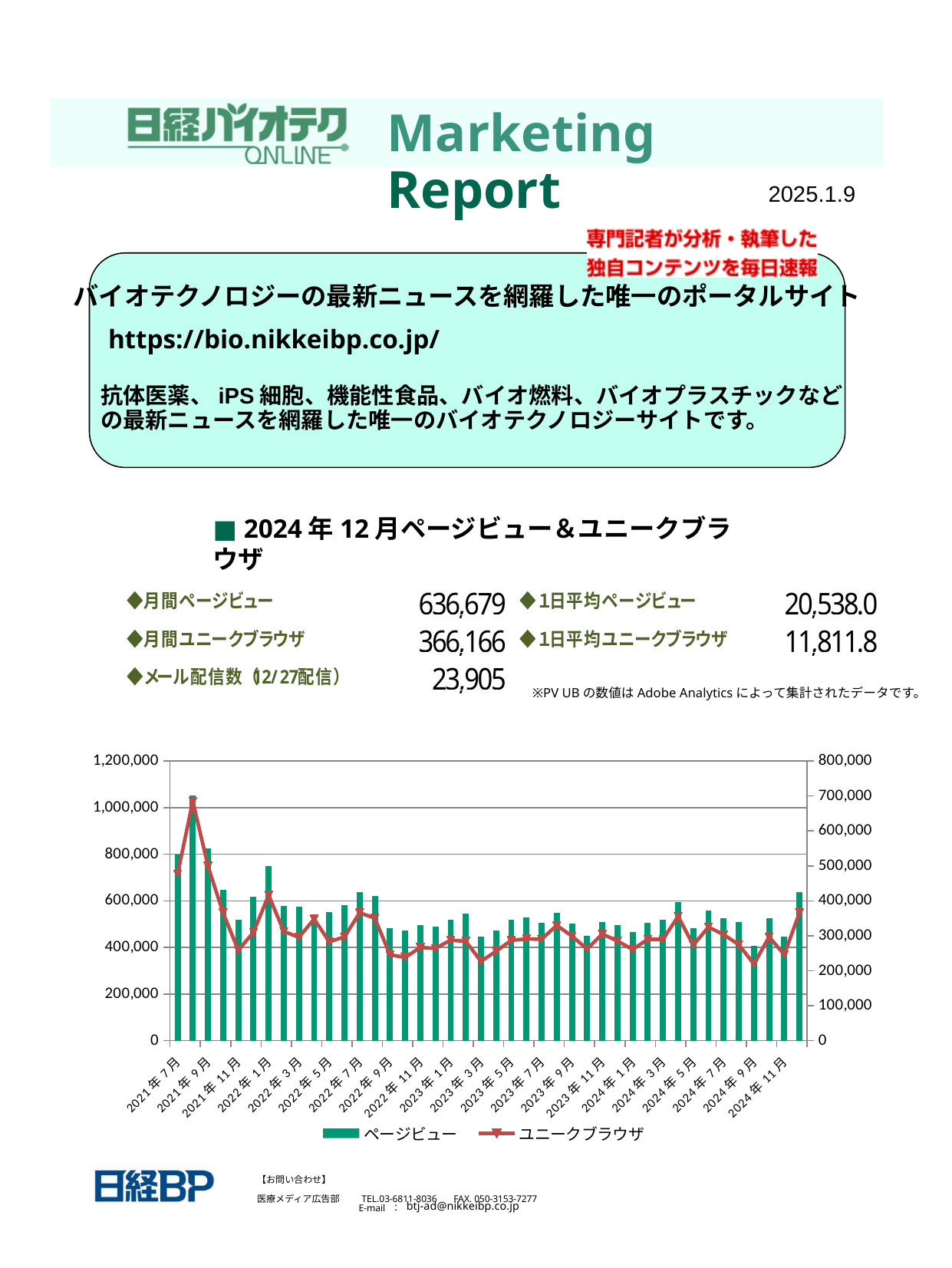
Which series is drawn as bars in the chart? ページビュー Is the ユニークブラウザ value for 2021年9月 greater or less than 600,000 on the right axis? less Overall, do the ページビュー values rise or fall from 2021年7月 to 2024年12月? fall Is the ページビュー value for 2024年9月 greater or less than 600,000? less What kind of chart is shown on the slide? A combined bar and line chart In which month is the ページビュー bar highest? 2021年8月 Which month has the larger ページビュー value, 2021年9月 or 2024年9月? 2021年9月 Is the ページビュー value for 2021年7月 greater or less than 600,000? greater Which month has the larger ページビュー value, 2022年1月 or 2022年3月? 2022年1月 How many series does the chart legend list? 2 In which month does the ユニークブラウザ line reach its highest point? 2021年8月 Which series is drawn as a line in the chart? ユニークブラウザ